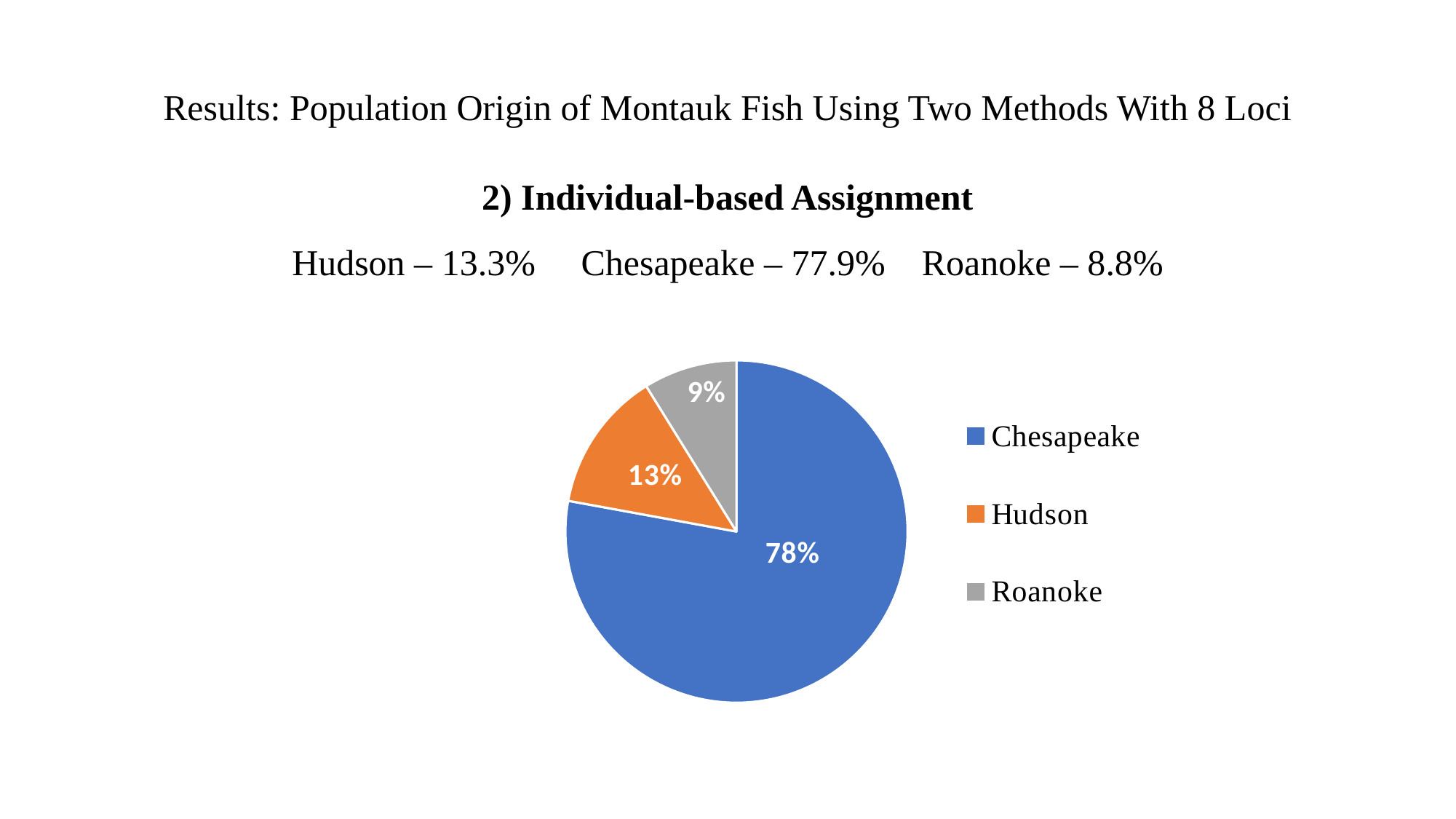
How many entries does the legend of the pie chart list? 3 What percentage does the pie chart show for Chesapeake? 78% What kind of chart is shown on the slide? pie chart What colour is the Chesapeake slice in the pie chart? blue Which slice is larger in the pie chart, Hudson or Roanoke? Hudson What colour is the Hudson slice in the pie chart? orange What percentage does the pie chart show for Roanoke? 9% What is the difference in percentage points between the Chesapeake and Hudson slices in the pie chart? 65 What percentage does the pie chart show for Hudson? 13% Which population has the largest slice of the pie chart? Chesapeake Which population has the smallest slice of the pie chart? Roanoke How many slices does the pie chart have? 3